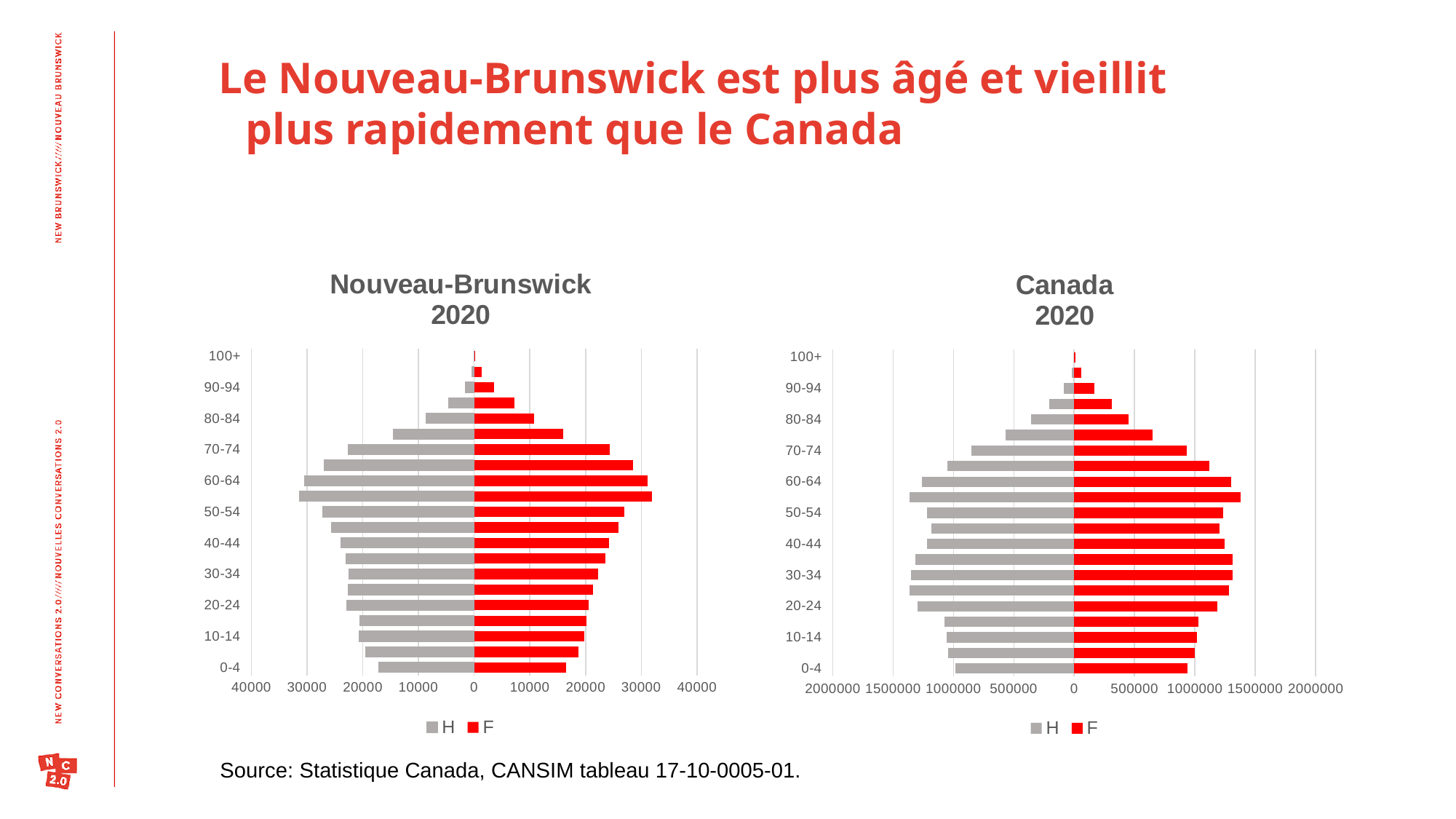
In the Nouveau-Brunswick 2020 chart, is the F value for the 0-4 age group greater or less than 20000? less In the Canada 2020 chart, is the H value for the 70-74 age group greater or less than 1000000? less In the Nouveau-Brunswick 2020 chart, which F bar is longer: the 60-64 age group or the 0-4 age group? 60-64 In the Canada 2020 chart, is the H value for the 80-84 age group greater or less than 500000? less What are the two legend entries in the Nouveau-Brunswick 2020 chart? H and F How many series does the legend of the Canada 2020 chart list? 2 In the Canada 2020 chart, which F bar is longer: the 60-64 age group or the 0-4 age group? 60-64 What kind of chart is the Nouveau-Brunswick 2020 chart? bar chart